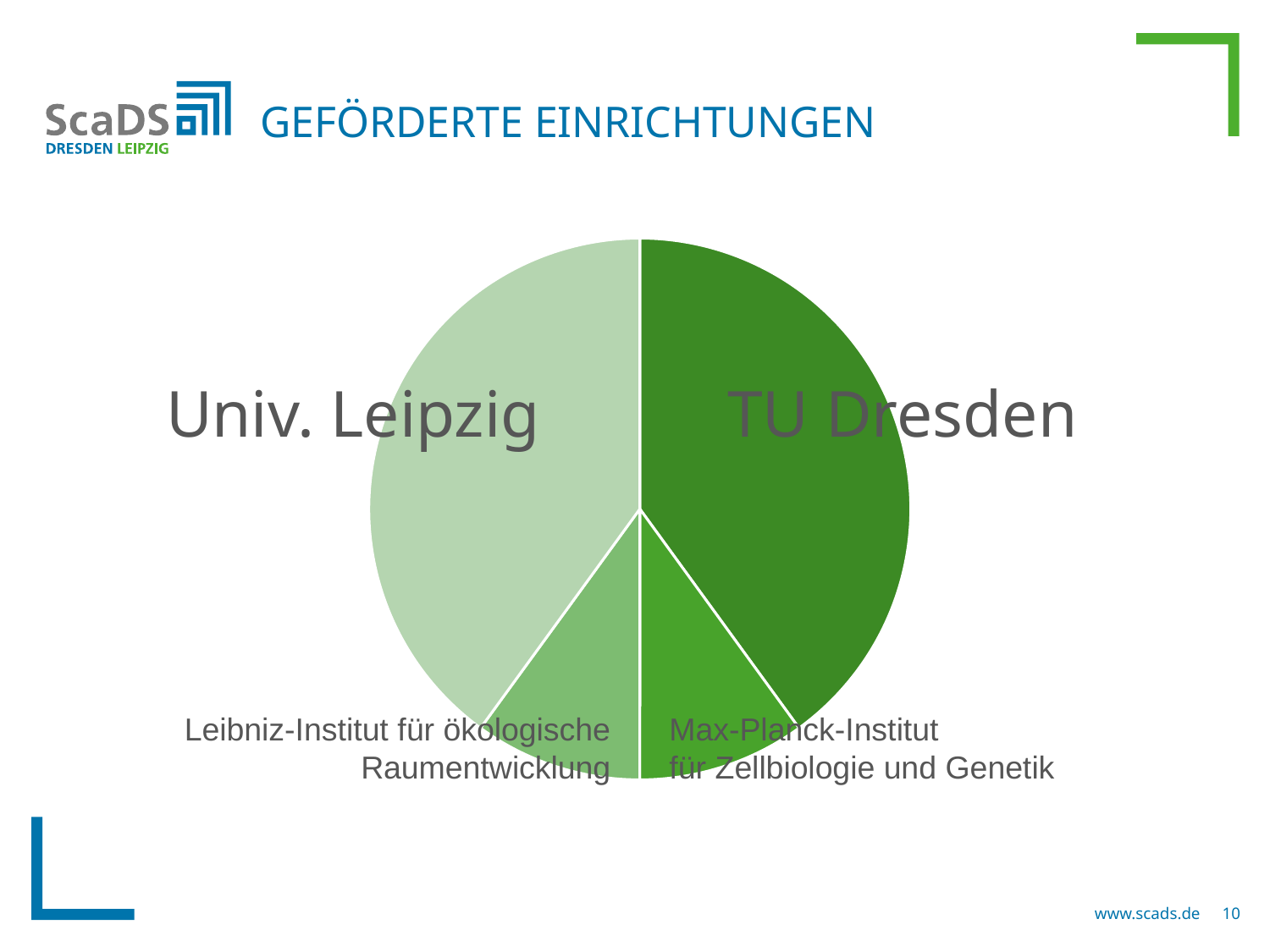
Which slice of the pie chart is drawn in the lightest green? Univ. Leipzig Which slice is larger, TU Dresden or Max-Planck-Institut für Zellbiologie und Genetik? TU Dresden Which slice is larger, Univ. Leipzig or Max-Planck-Institut für Zellbiologie und Genetik? Univ. Leipzig Which slice is larger, TU Dresden or Leibniz-Institut für ökologische Raumentwicklung? TU Dresden How many slices does the pie chart have? 4 What is the title of the slide containing the pie chart? GEFÖRDERTE EINRICHTUNGEN What kind of chart is shown on the slide? pie chart